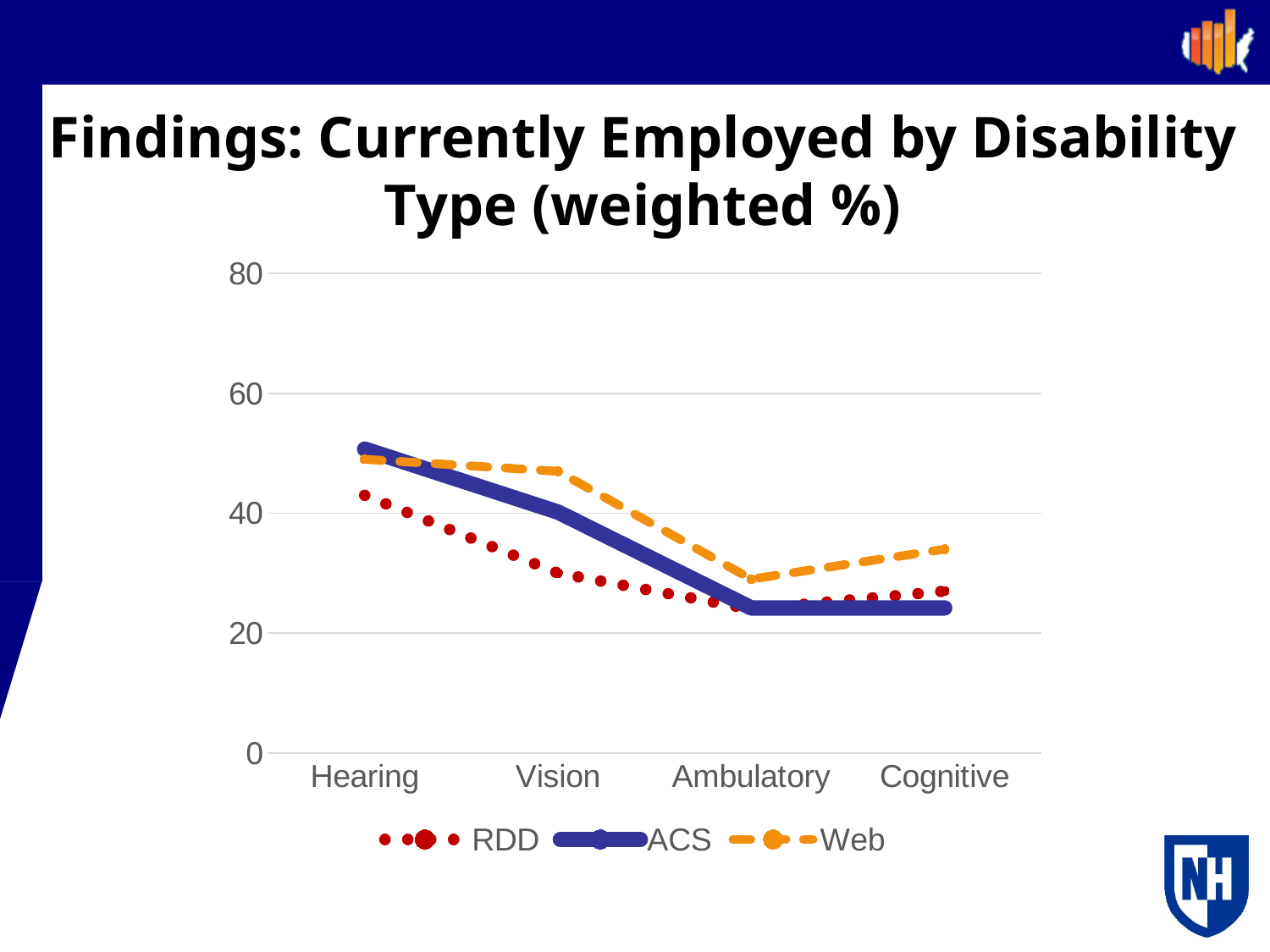
How many series does the legend list? 3 Does the ACS series rise or fall from Hearing to Ambulatory? fall Is the RDD value for Vision greater or less than 40? less For which disability type is the Web series highest? Hearing What kind of chart is shown on the slide? line chart Is the ACS value for Cognitive greater or less than 20? greater Is the Web value for Ambulatory greater or less than 40? less For Vision, which series has the larger value, RDD or Web? Web For which disability type is the RDD series lowest? Ambulatory Which series are listed in the legend? RDD, ACS, Web How many disability types are shown on the x axis? 4